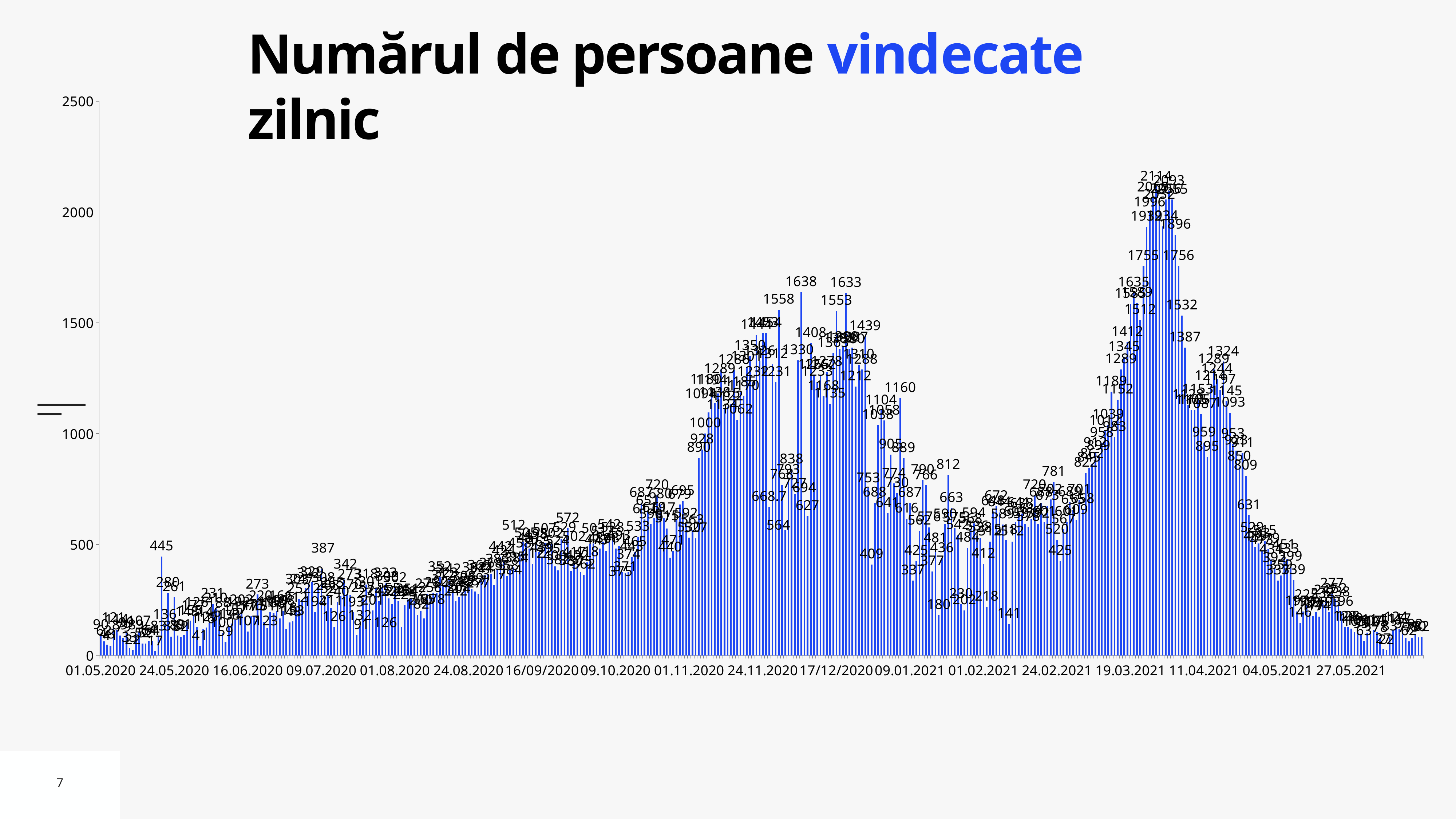
In which period of the x axis does the tallest peak of the chart occur? between 19.03.2021 and 11.04.2021 What kind of chart is shown on the slide? bar chart What is the highest data label in the peak between 24.11.2020 and 17/12/2020? 1638 How many date labels are shown on the x axis? 18 What is the difference between the overall peak value 2114 and the late-2020 peak value 1638? 476 Which is larger, the bar labeled 1638 or the bar labeled 1633? 1638 What is the highest tick value on the vertical axis? 2500 Is the bar labeled 445 in May 2020 greater or less than 500? less What is the highest data label shown on the chart? 2114 Do the values rise or fall from the peak around 11.04.2021 to 27.05.2021? fall Is the highest value on the chart greater or less than 2000? greater What is the title of the chart? Numărul de persoane vindecate zilnic